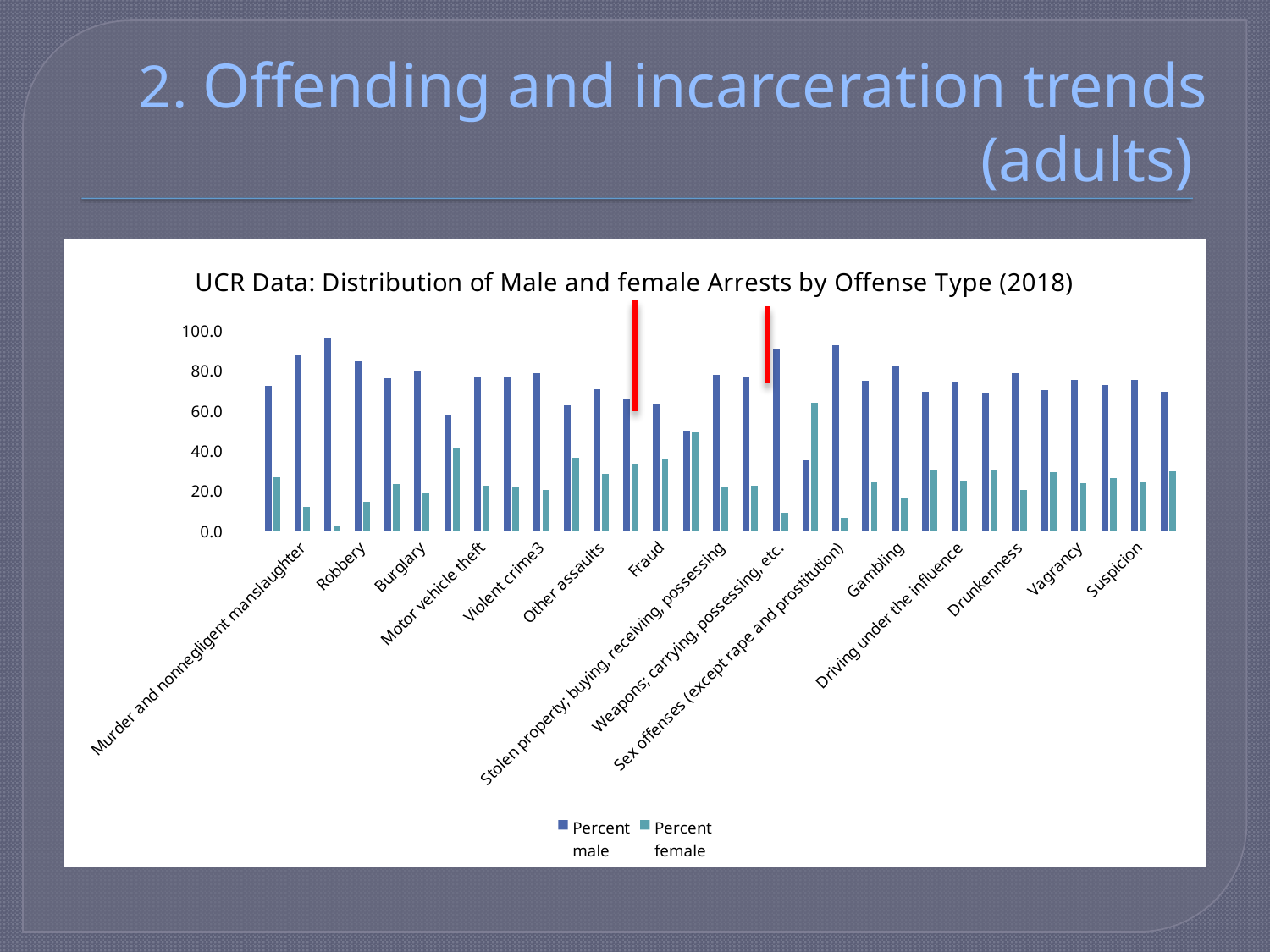
Is the Percent female value for Suspicion greater or less than 20? greater Is the Percent male value for Murder and nonnegligent manslaughter greater or less than 60? greater Which has the larger Percent female value, Fraud or Weapons; carrying, possessing, etc.? Fraud Is the Percent male value for Weapons; carrying, possessing, etc. greater or less than 80? greater What kind of chart is shown on the slide? Bar chart What are the two series named in the legend? Percent male and Percent female How many series does the chart's legend list? 2 Which has the larger Percent male value, Robbery or Murder and nonnegligent manslaughter? Murder and nonnegligent manslaughter What is the title of the chart? UCR Data: Distribution of Male and female Arrests by Offense Type (2018)